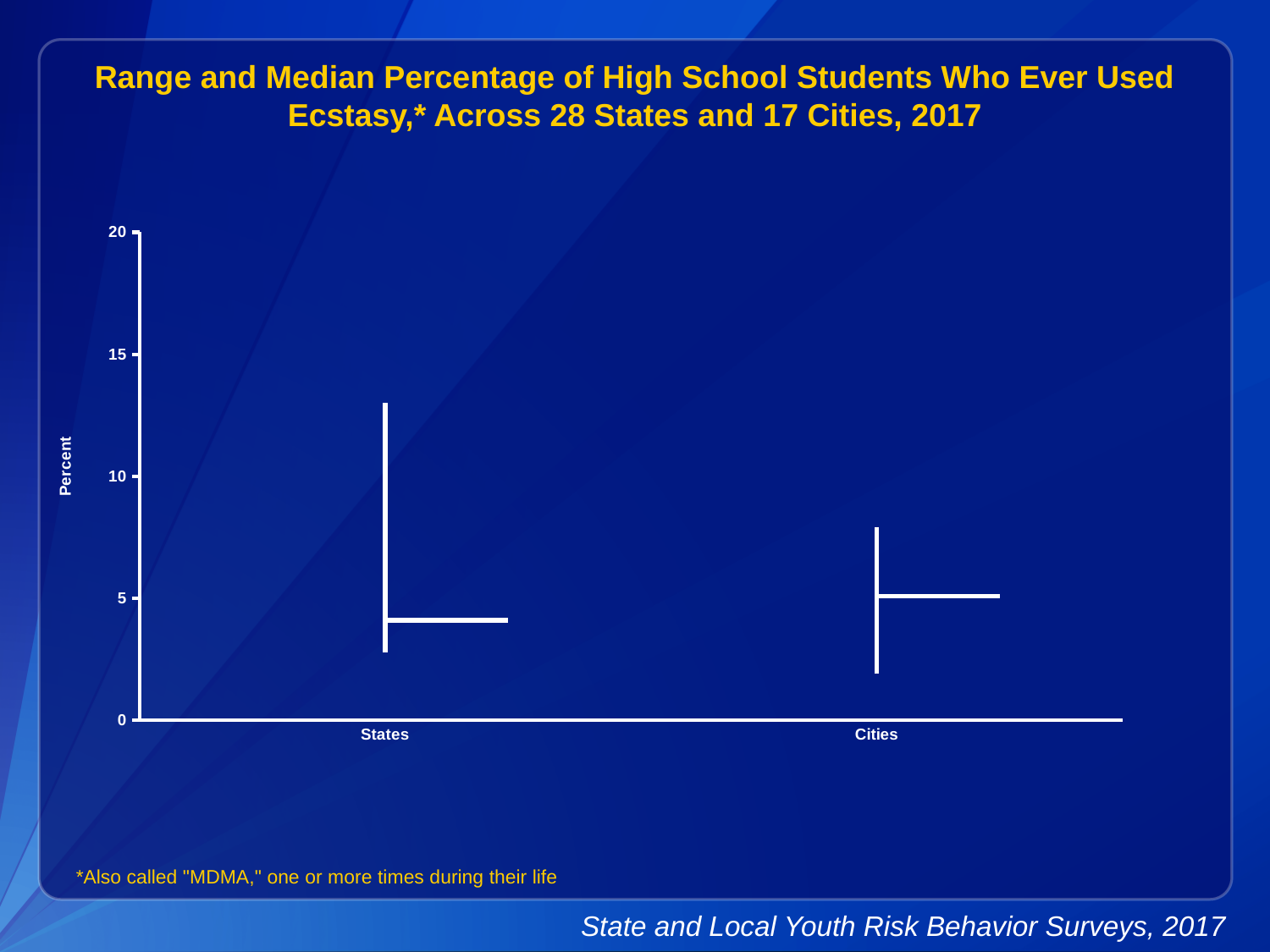
Is the bottom of the range for States greater or less than 5? less Is the bottom of the range for Cities greater or less than 5? less Is the top of the range for States greater or less than 10? greater What is the title of the chart? Range and Median Percentage of High School Students Who Ever Used Ecstasy,* Across 28 States and 17 Cities, 2017 Which category has the higher median, States or Cities? Cities How many categories are shown on the x axis? 2 What is the highest value shown on the vertical axis? 20 Which category has the higher maximum value in its range, States or Cities? States What is the label on the vertical axis? Percent